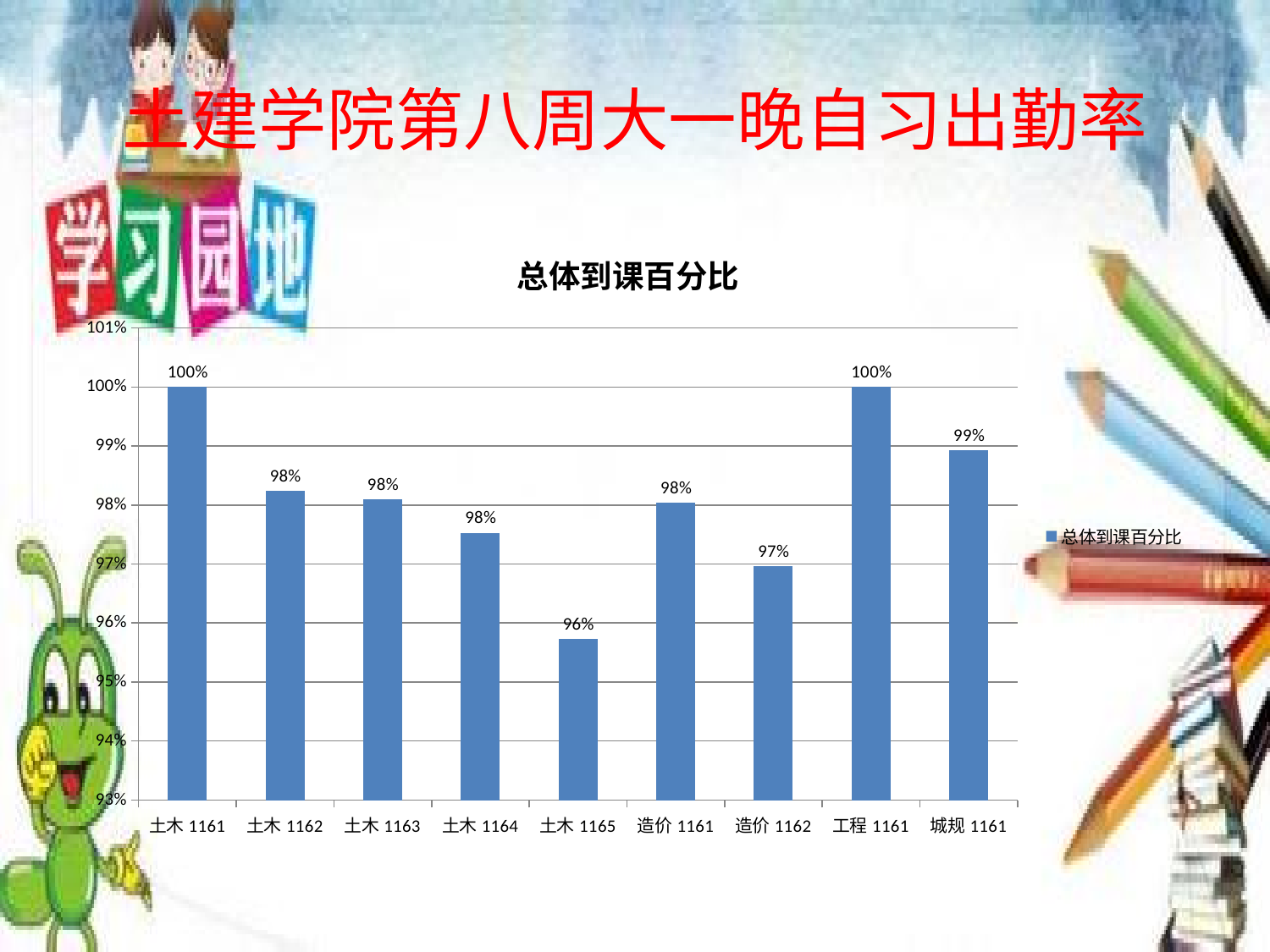
What is the value for 土木 1161? 100% How many categories are shown on the x axis? 9 Is the value for 土木 1165 greater or less than 97%? less What kind of chart is shown? bar chart What is the value for 土木 1165? 96% Which category has the lowest value? 土木 1165 How many series does the legend list? 1 What is the value for 城规 1161? 99% Is the value for 城规 1161 greater or less than 98%? greater What is the difference between the values for 土木 1161 and 土木 1165? 4% What is the value for 造价 1162? 97% Which is larger, the value for 工程 1161 or the value for 造价 1162? 工程 1161